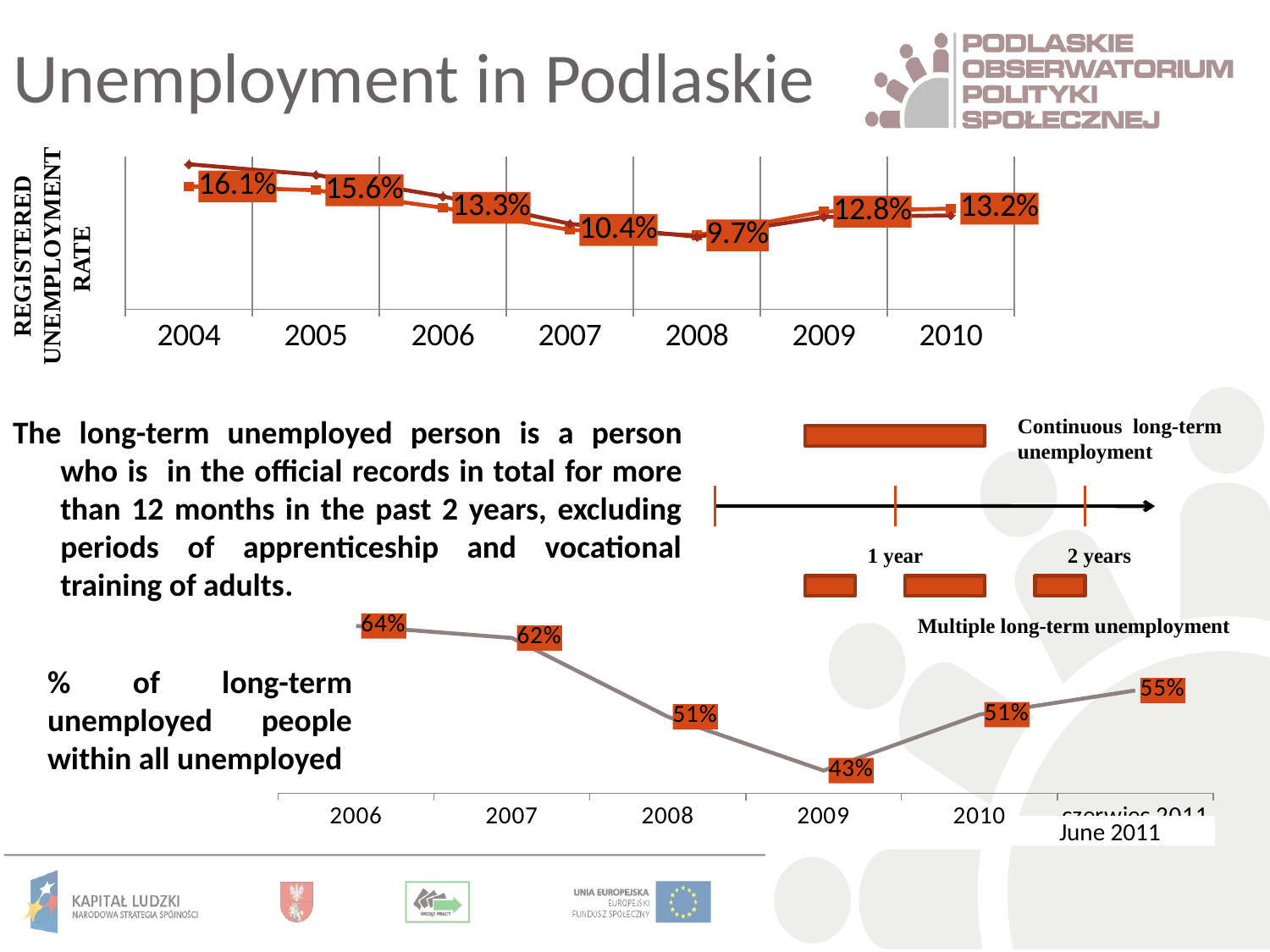
In the registered unemployment rate chart at the top, how many years are shown on the x axis? 7 In the registered unemployment rate chart at the top, what value is labelled for 2008? 9.7% In the registered unemployment rate chart at the top, which year has the lowest labelled value? 2008 In the bottom chart showing the % of long-term unemployed people within all unemployed, what is the value for 2009? 43% In the bottom chart showing the % of long-term unemployed people within all unemployed, what is the difference between the values for 2006 and 2009? 21 percentage points In the registered unemployment rate chart at the top, which year has the highest labelled value? 2004 In the bottom chart showing the % of long-term unemployed people within all unemployed, what is the value for June 2011? 55% In the bottom chart showing the % of long-term unemployed people within all unemployed, which period has the highest value? 2006 In the registered unemployment rate chart at the top, what is the difference between the labelled values for 2004 and 2008? 6.4 percentage points In the registered unemployment rate chart at the top, what value is labelled for 2004? 16.1% What type of chart is the bottom chart showing the % of long-term unemployed people within all unemployed? line chart In the registered unemployment rate chart at the top, do the labelled values rise or fall from 2004 to 2008? fall